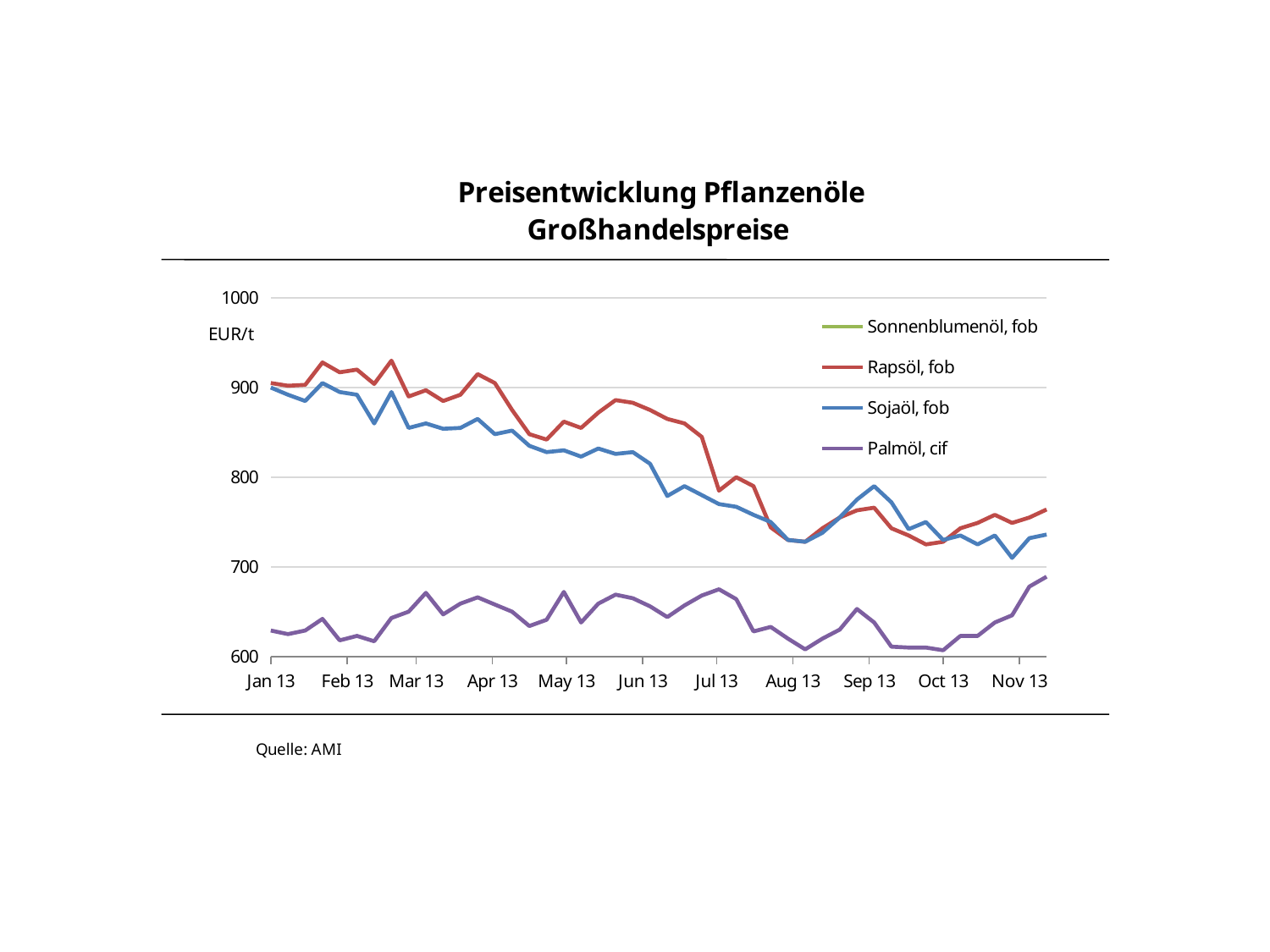
Is the value for Sojaöl, fob at Nov 13 greater or less than 800? less Is the value for Rapsöl, fob at Aug 13 greater or less than 800? less At Nov 13, which is higher: Sojaöl, fob or Palmöl, cif? Sojaöl, fob Does the Rapsöl, fob price rise or fall overall from Jan 13 to Nov 13? fall What is the title of the chart? Preisentwicklung Pflanzenöle Großhandelspreise Is the value for Palmöl, cif at Jan 13 greater or less than 700? less Which series has the highest value at Apr 13? Rapsöl, fob What unit is shown on the y axis of the chart? EUR/t Which series has the lowest values across the whole period? Palmöl, cif What kind of chart is shown on the slide? line chart How many series does the legend list? 4